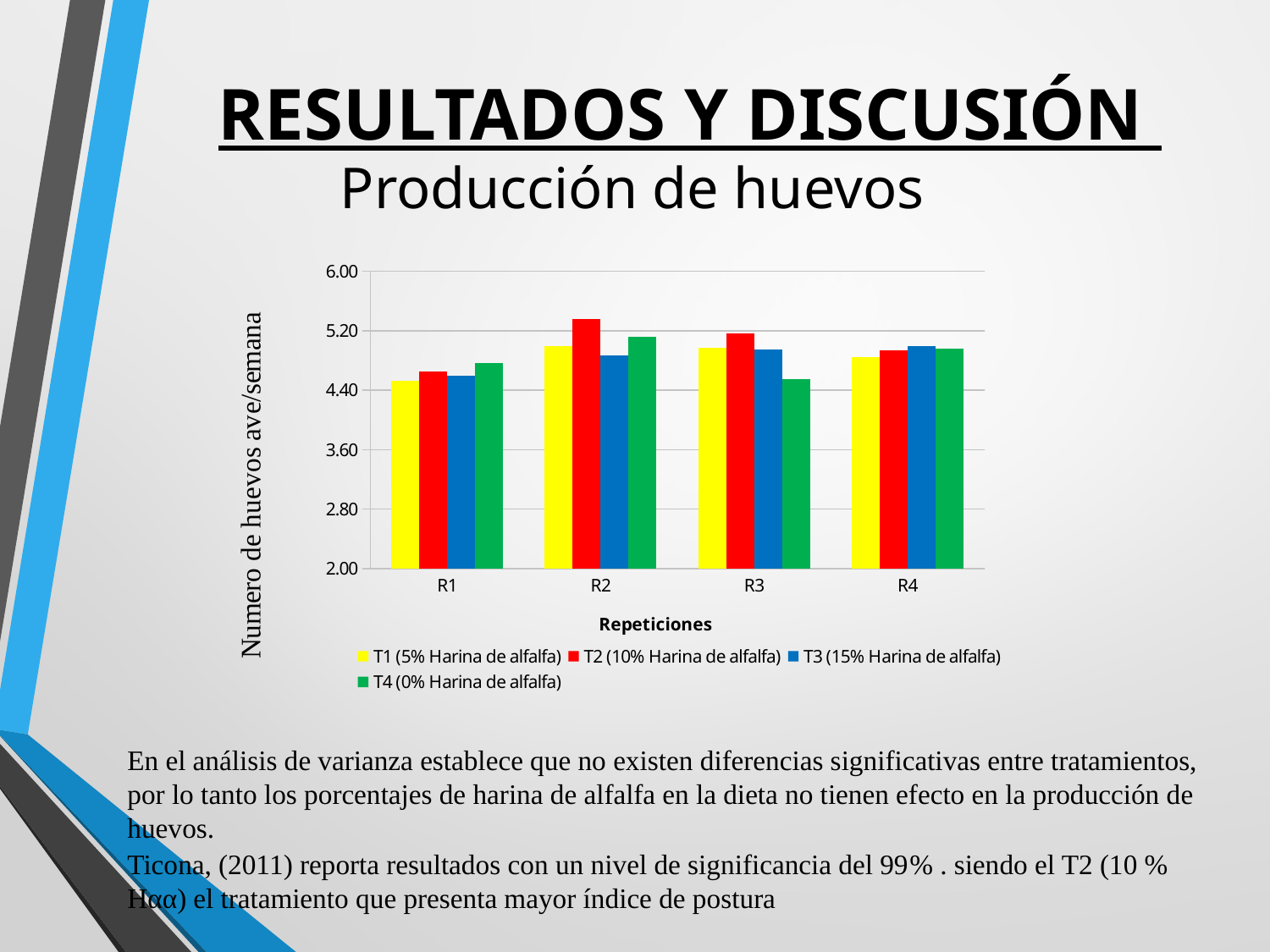
Which is larger: the value for T2 (10% Harina de alfalfa) at R2 or at R1? R2 Is the value for T2 (10% Harina de alfalfa) at R2 greater or less than 5.20? greater Is the value for T4 (0% Harina de alfalfa) at R3 greater or less than 5.20? less Which legend entry is shown in green? T4 (0% Harina de alfalfa) How many series does the legend list? 4 Within R3, which series has the lowest bar? T4 (0% Harina de alfalfa) How many repetition categories are shown on the x axis? 4 Which series and repetition has the highest bar in the chart? T2 (10% Harina de alfalfa) at R2 Is the value for T1 (5% Harina de alfalfa) at R1 greater or less than 5.20? less Which is larger: the value for T4 (0% Harina de alfalfa) at R2 or at R3? R2 What kind of chart is shown on the slide? bar chart What is the title of the x axis of the chart? Repeticiones